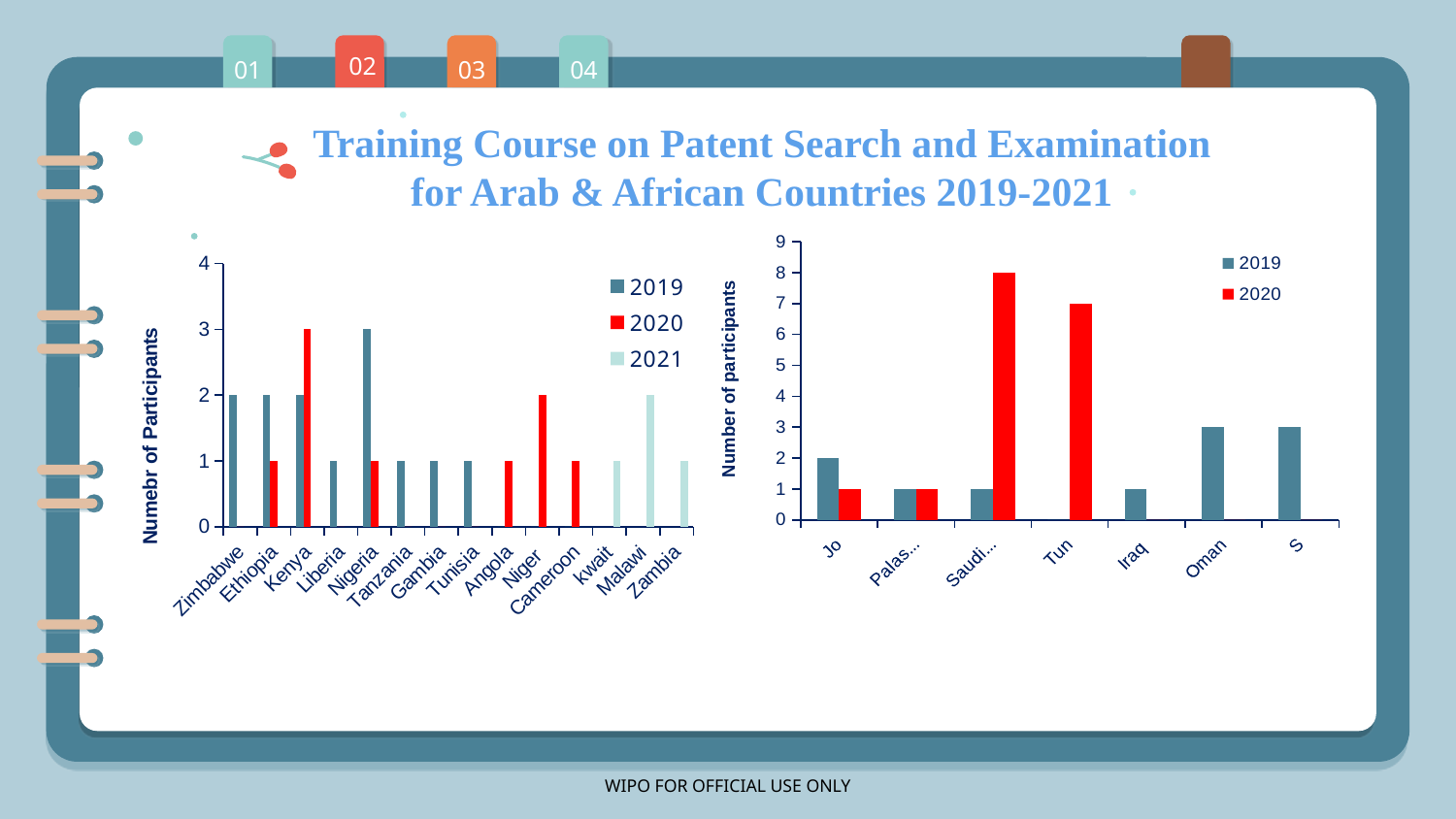
On the right chart, what is the 2020 value for Tun? 7 On the left chart, what is the 2019 value for Nigeria? 3 On the right chart, what is the 2019 value for Oman? 3 On the left chart, what is the 2020 value for Kenya? 3 On the left chart, which category has the highest 2020 value? Kenya What kind of chart is the right chart? bar chart On the left chart, how many categories are shown on the x axis? 14 On the right chart, what is the difference between the 2019 and 2020 values for Jo? 1 On the left chart, what is the 2021 value for Malawi? 2 On the right chart, which category has the highest 2020 value? Saudi... On the left chart, how many series does the legend list? 3 On the right chart, how many series does the legend list? 2